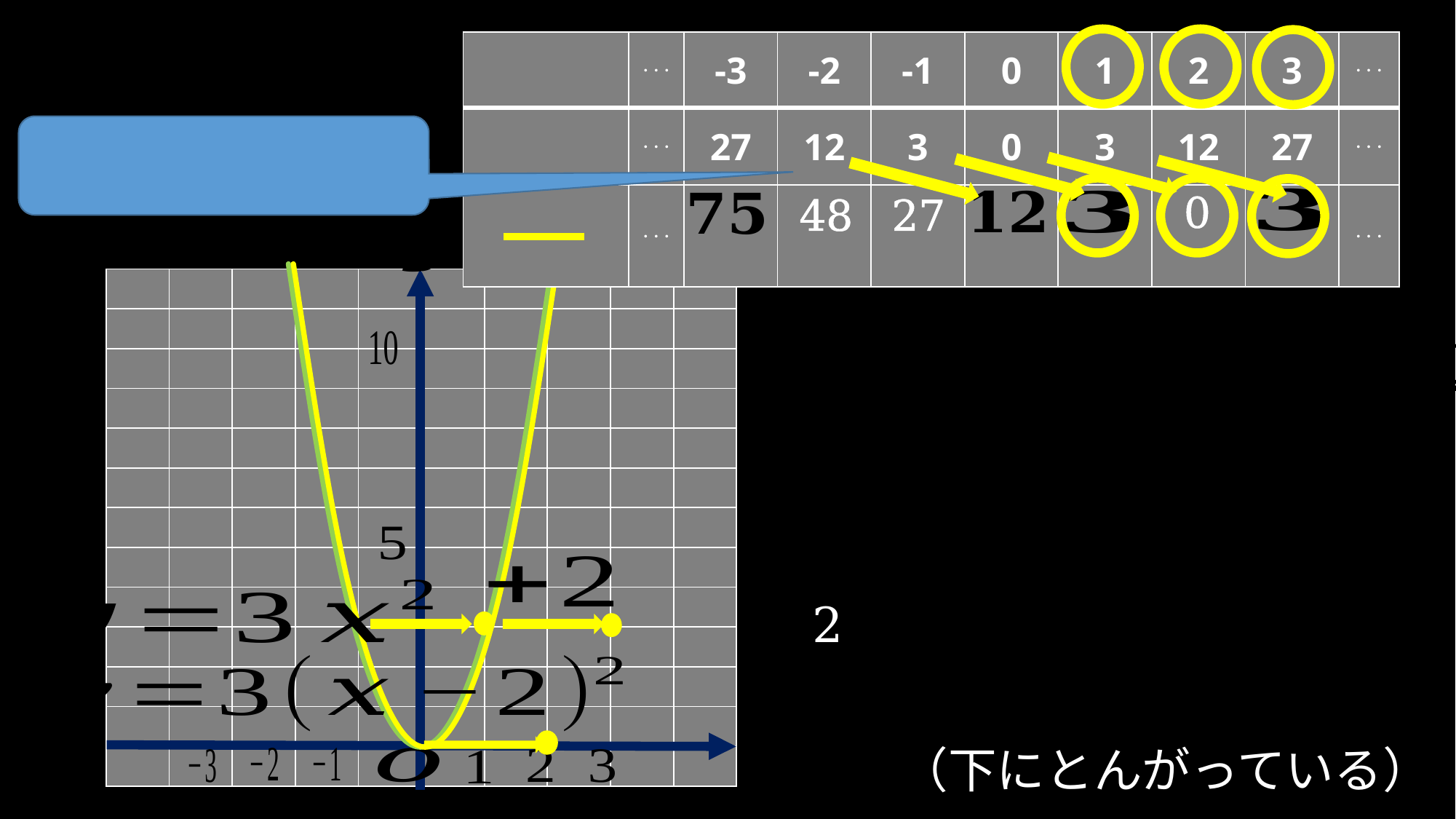
How many curves are plotted on the graph? 2 How many x values (excluding the ellipses) are listed in the table above the graph? 7 Is the value of the green curve y = 3x² at x = 1 greater or less than 5? less At x = -1, which is larger according to the table: y = 3x² or y = 3(x-2)²? y = 3(x-2)² According to the table, what is the value of y = 3(x-2)² at x = 2? 0 At which x value does the yellow curve y = 3(x-2)² reach its minimum? 2 At which x value does the curve y = 3x² reach its minimum? 0 What kind of chart is shown on the slide? line chart (graph of parabolas) According to the table, what is the value of y = 3(x-2)² at x = -3? 75 As x goes from -3 to 0, do the values of y = 3x² in the table rise or fall? fall What is the difference between the values of y = 3(x-2)² and y = 3x² at x = -3 in the table? 48 According to the table, what is the value of y = 3x² at x = -3? 27